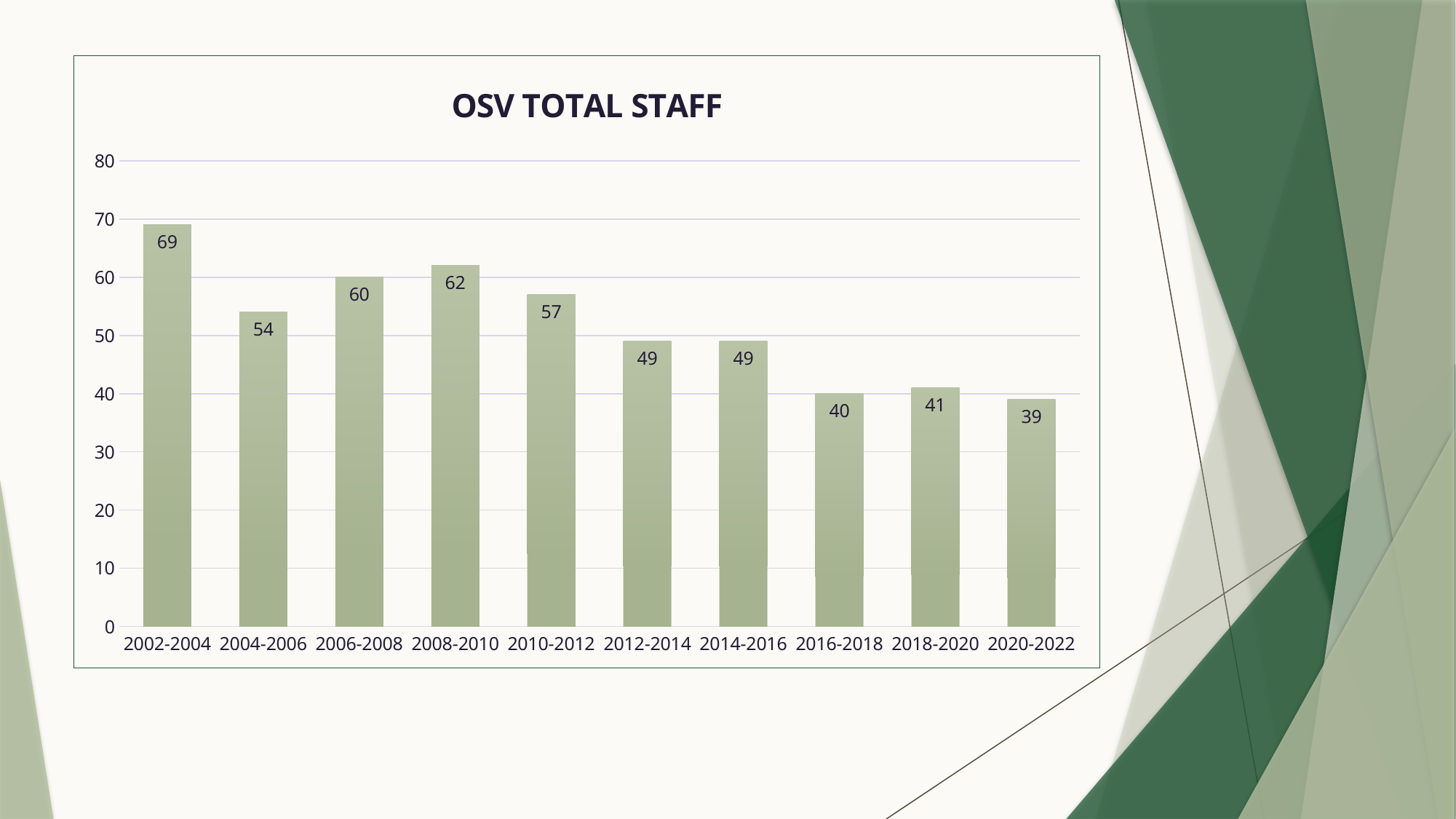
What kind of chart is shown on the slide? Bar chart What is the OSV total staff for 2002-2004? 69 What is the title of the chart? OSV TOTAL STAFF Is the OSV total staff for 2004-2006 greater or less than 50? greater What is the OSV total staff for 2020-2022? 39 How many periods are shown on the x axis of the chart? 10 What is the OSV total staff for 2010-2012? 57 Which period has a larger OSV total staff, 2006-2008 or 2016-2018? 2006-2008 Which period has the highest OSV total staff? 2002-2004 What is the difference in OSV total staff between 2008-2010 and 2004-2006? 8 Which period has the lowest OSV total staff? 2020-2022 What is the difference in OSV total staff between 2002-2004 and 2020-2022? 30